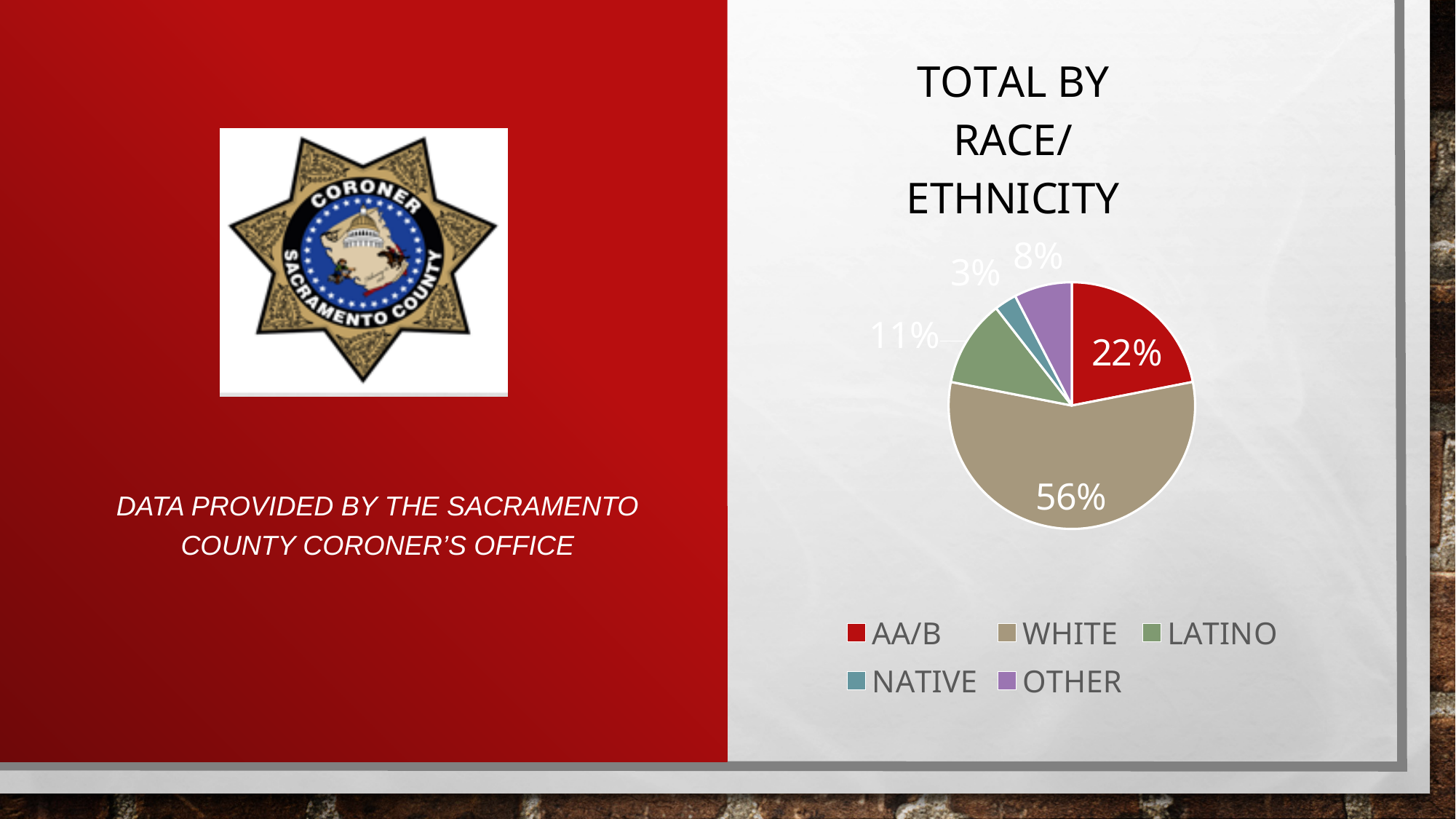
How many categories does the legend list? 5 What is the difference in percentage points between WHITE and AA/B? 34 What percentage of the pie is NATIVE? 3% What percentage of the pie is AA/B? 22% Which category has the smallest share of the pie? NATIVE Which is larger, the share for LATINO or the share for OTHER? LATINO What percentage of the pie is OTHER? 8% What percentage of the pie is WHITE? 56% What percentage of the pie is LATINO? 11% Which category has the largest share of the pie? WHITE What is the title of the chart? TOTAL BY RACE/ETHNICITY What type of chart is shown on the slide? pie chart